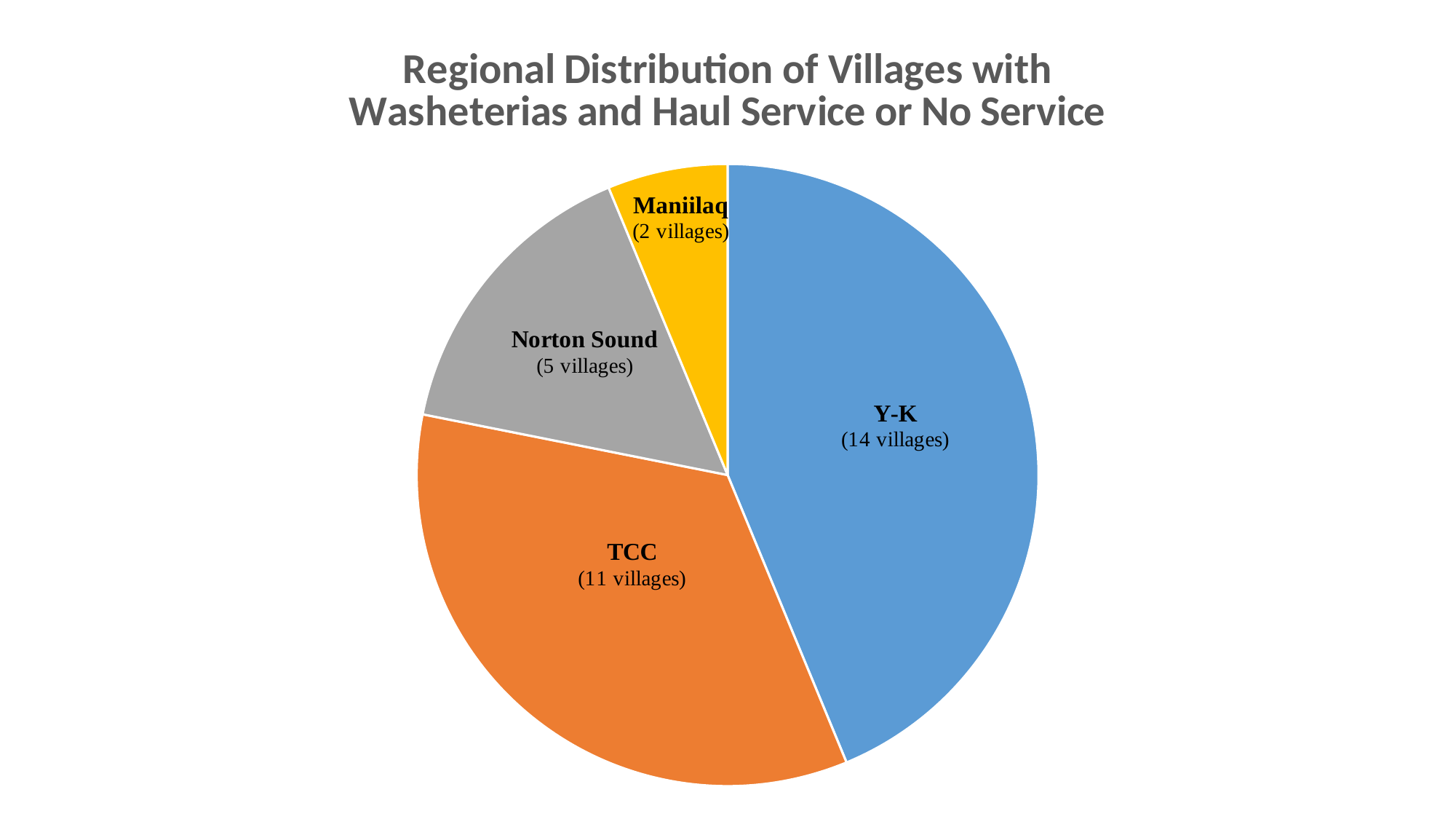
Which has more villages, TCC or Norton Sound? TCC How many regions are shown in the pie chart? 4 How many villages does the TCC slice represent? 11 villages How many villages does the Y-K slice represent? 14 villages How many more villages does Y-K have than TCC? 3 How many villages does the Maniilaq slice represent? 2 villages What type of chart is shown on the slide? pie chart Which region has the smallest slice of the pie? Maniilaq What is the title of the chart? Regional Distribution of Villages with Washeterias and Haul Service or No Service Which region has the largest slice of the pie? Y-K How many more villages does Norton Sound have than Maniilaq? 3 How many villages does the Norton Sound slice represent? 5 villages